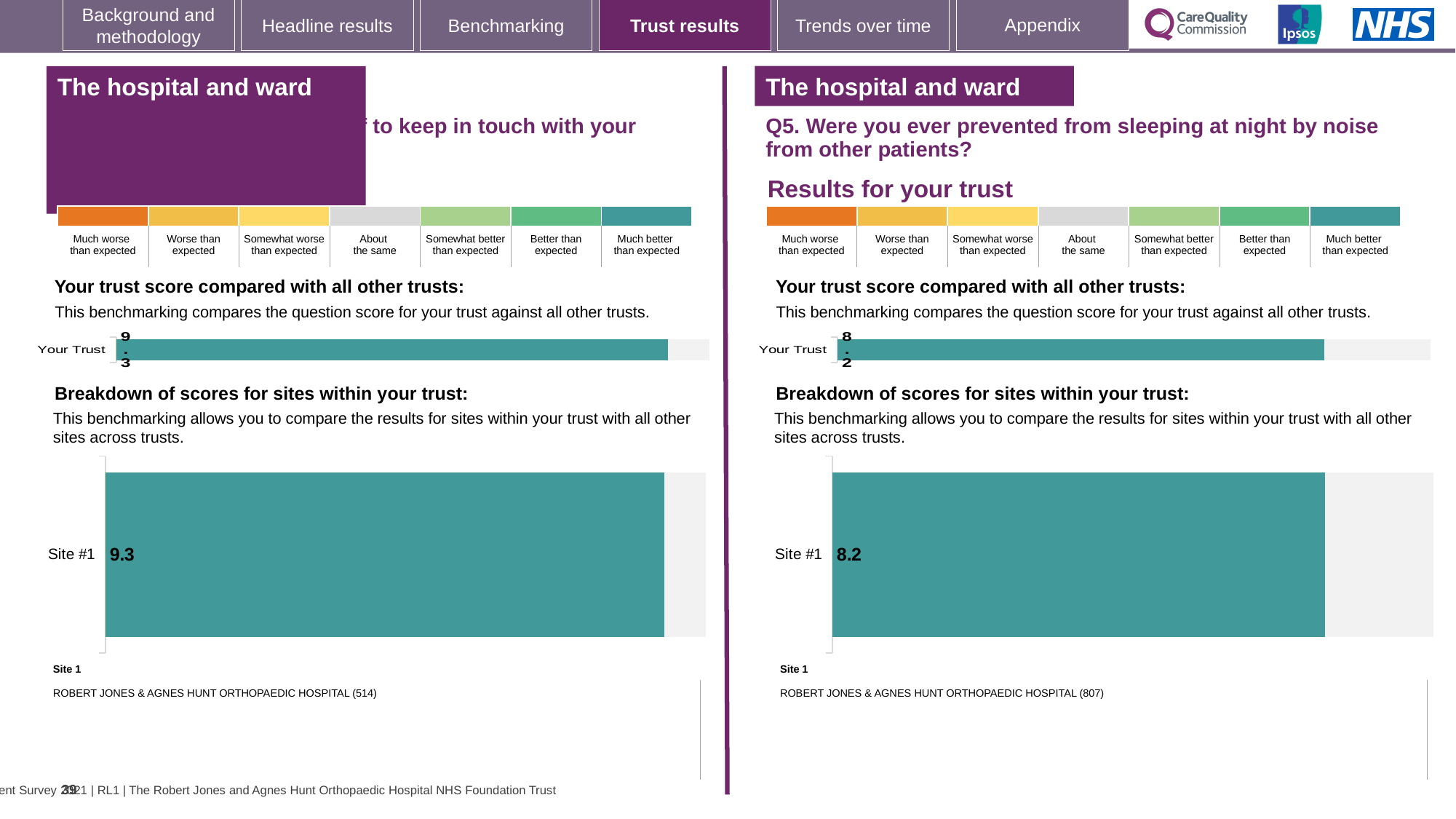
On the right-hand side of the slide (Q5, prevented from sleeping by noise from other patients), what is the score shown for Your Trust? 8.2 On the left-hand side of the slide, what is the score shown for Your Trust? 9.3 What is the difference between the Site #1 score on the left-hand side (9.3) and the Site #1 score on the right-hand side (8.2)? 1.1 How many sites are shown in the left-hand 'Breakdown of scores for sites within your trust' chart? 1 In the right-hand 'Breakdown of scores for sites within your trust' chart (Q5), what is the score for Site #1? 8.2 In the left-hand 'Breakdown of scores for sites within your trust' chart, what is the score for Site #1? 9.3 Is the Site #1 score in the left-hand breakdown chart greater or less than the Site #1 score in the right-hand breakdown chart? greater Which is larger: the Your Trust score on the left-hand side of the slide or the Your Trust score on the right-hand side (Q5)? Left-hand side (9.3) Which site is listed as Site 1 beneath the right-hand breakdown chart? ROBERT JONES & AGNES HUNT ORTHOPAEDIC HOSPITAL (807) How many sites are shown in the right-hand 'Breakdown of scores for sites within your trust' chart? 1 What colour is the bar for Your Trust in the left-hand 'Your trust score compared with all other trusts' chart? Teal What type of chart is used to show the Site #1 score on the right-hand side of the slide? Bar chart